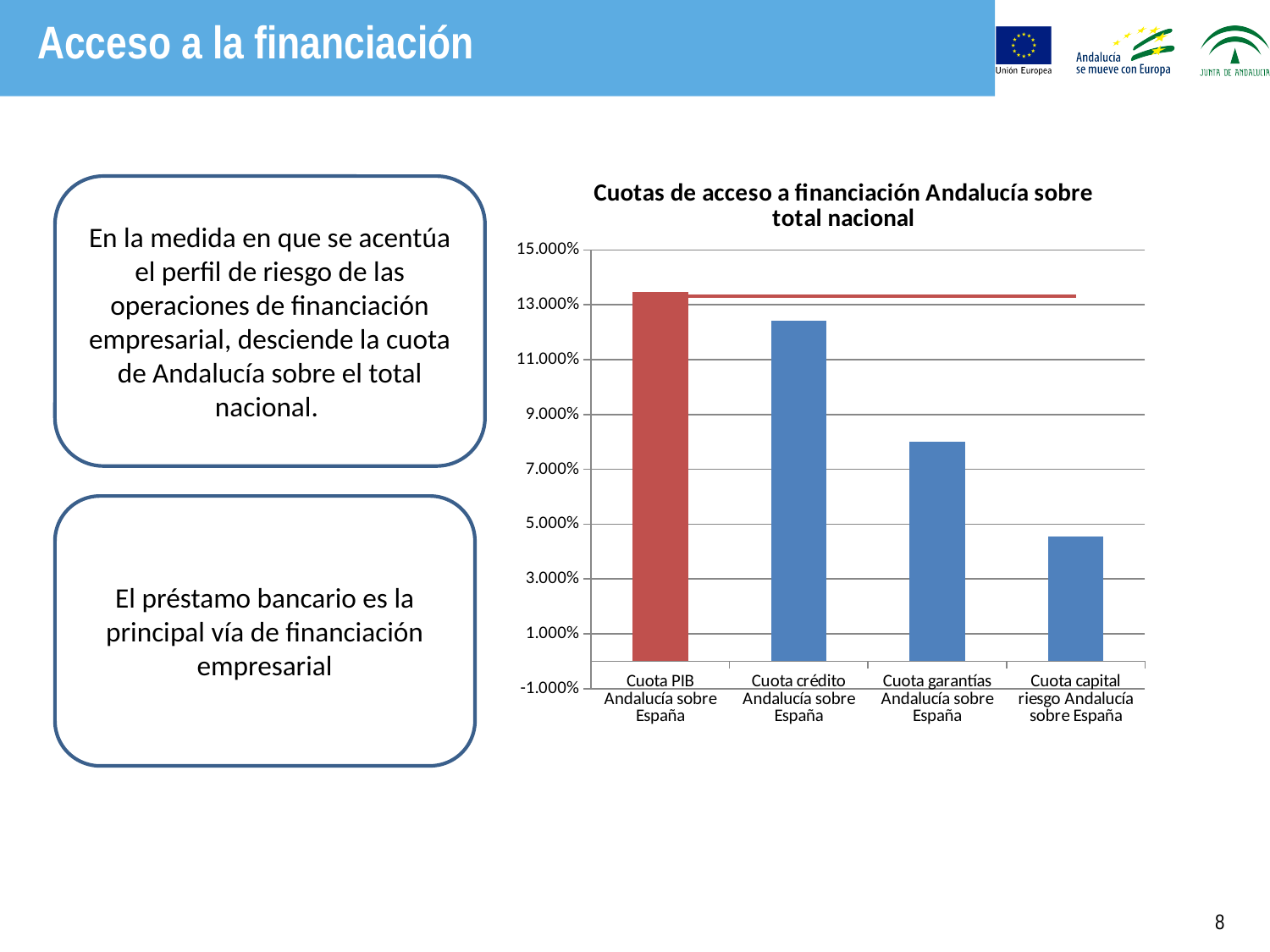
Which is larger, the value for Cuota garantías Andalucía sobre España or the value for Cuota capital riesgo Andalucía sobre España? Cuota garantías Andalucía sobre España Which category has the lowest value in the chart? Cuota capital riesgo Andalucía sobre España Which category has the highest value in the chart? Cuota PIB Andalucía sobre España Is the value for Cuota PIB Andalucía sobre España greater or less than 13.000%? greater What is the title of the chart? Cuotas de acceso a financiación Andalucía sobre total nacional Is the value for Cuota crédito Andalucía sobre España greater or less than 13.000%? less Which is larger, the value for Cuota crédito Andalucía sobre España or the value for Cuota garantías Andalucía sobre España? Cuota crédito Andalucía sobre España Do the bar values rise or fall from left to right along the x axis? fall How many categories are plotted in the chart? 4 Is the value for Cuota capital riesgo Andalucía sobre España greater or less than 5.000%? less What kind of chart is shown on the slide? combination bar and line chart